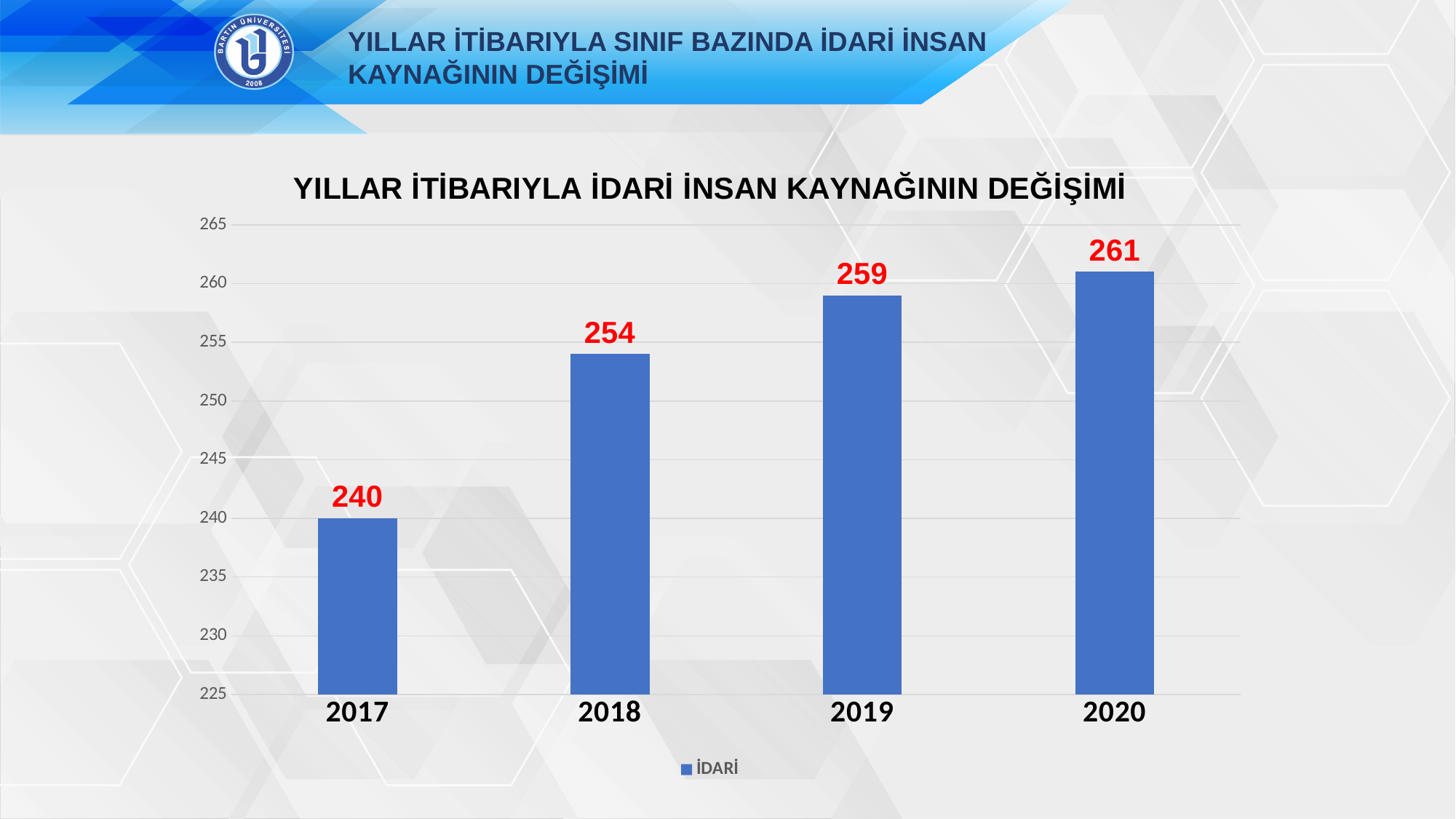
What is the value for 2019? 259 What is the value for 2020? 261 Which year has the highest value? 2020 Which year has the lowest value? 2017 What is the value for 2017? 240 What is the value for 2018? 254 What is the difference between the values for 2018 and 2017? 14 How many years are shown on the x axis? 4 Which is larger, the value for 2018 or the value for 2019? 2019 What kind of chart is this? bar chart Do the values rise or fall from 2017 to 2020? rise What is the difference between the values for 2020 and 2017? 21